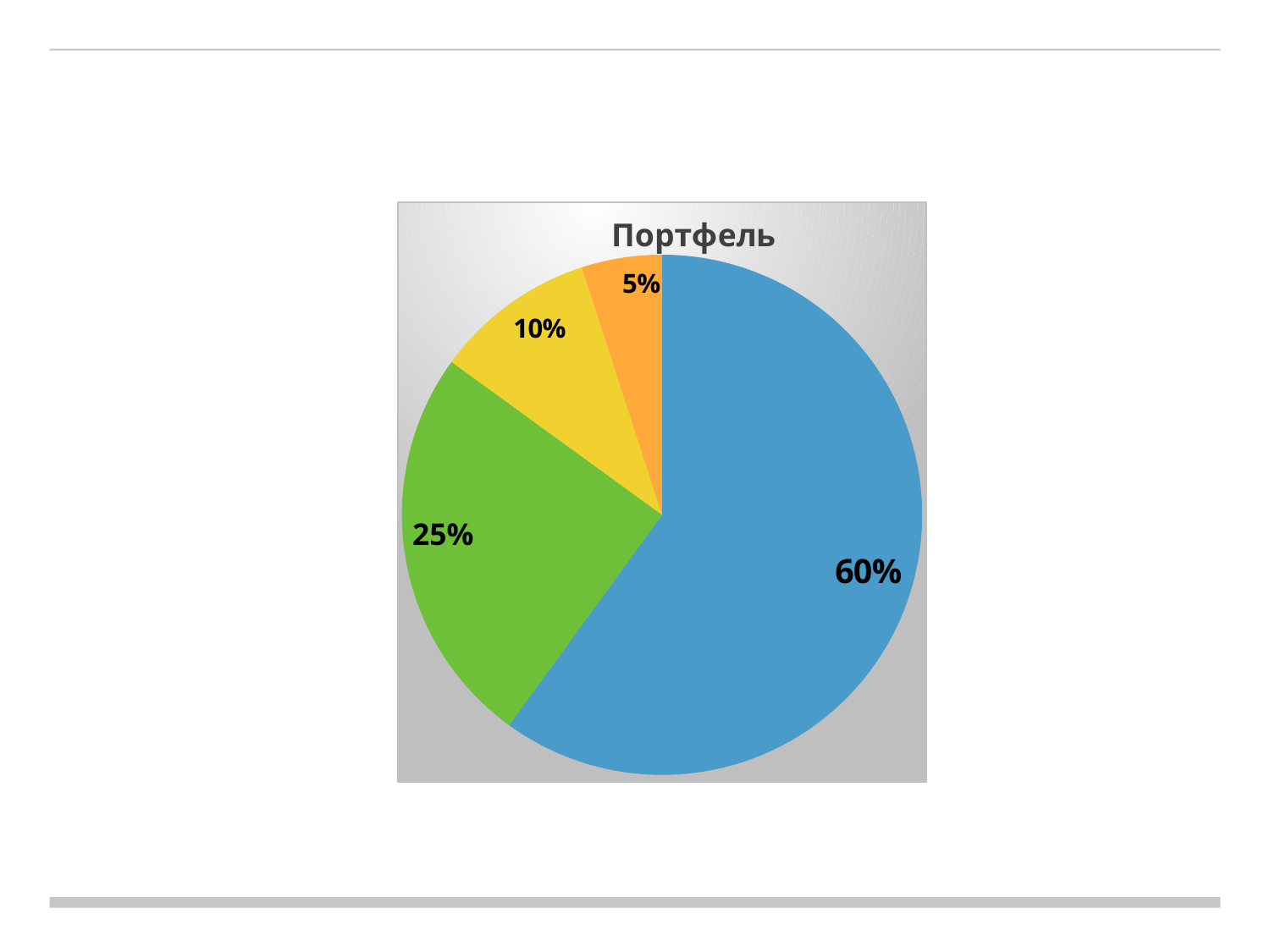
What percentage is shown on the yellow slice of the pie chart? 10% What kind of chart is shown on the slide? pie chart What is the title of the chart? Портфель Which colour slice is the largest in the pie chart? blue How many slices does the pie chart have? 4 Which is larger, the yellow slice or the orange slice? yellow What percentage is shown on the green slice of the pie chart? 25% What share of the pie do the green and yellow slices make up together? 35% What percentage is shown on the blue slice of the pie chart? 60% Which colour slice is the smallest in the pie chart? orange What is the difference between the blue slice and the green slice? 35% What percentage is shown on the orange slice of the pie chart? 5%